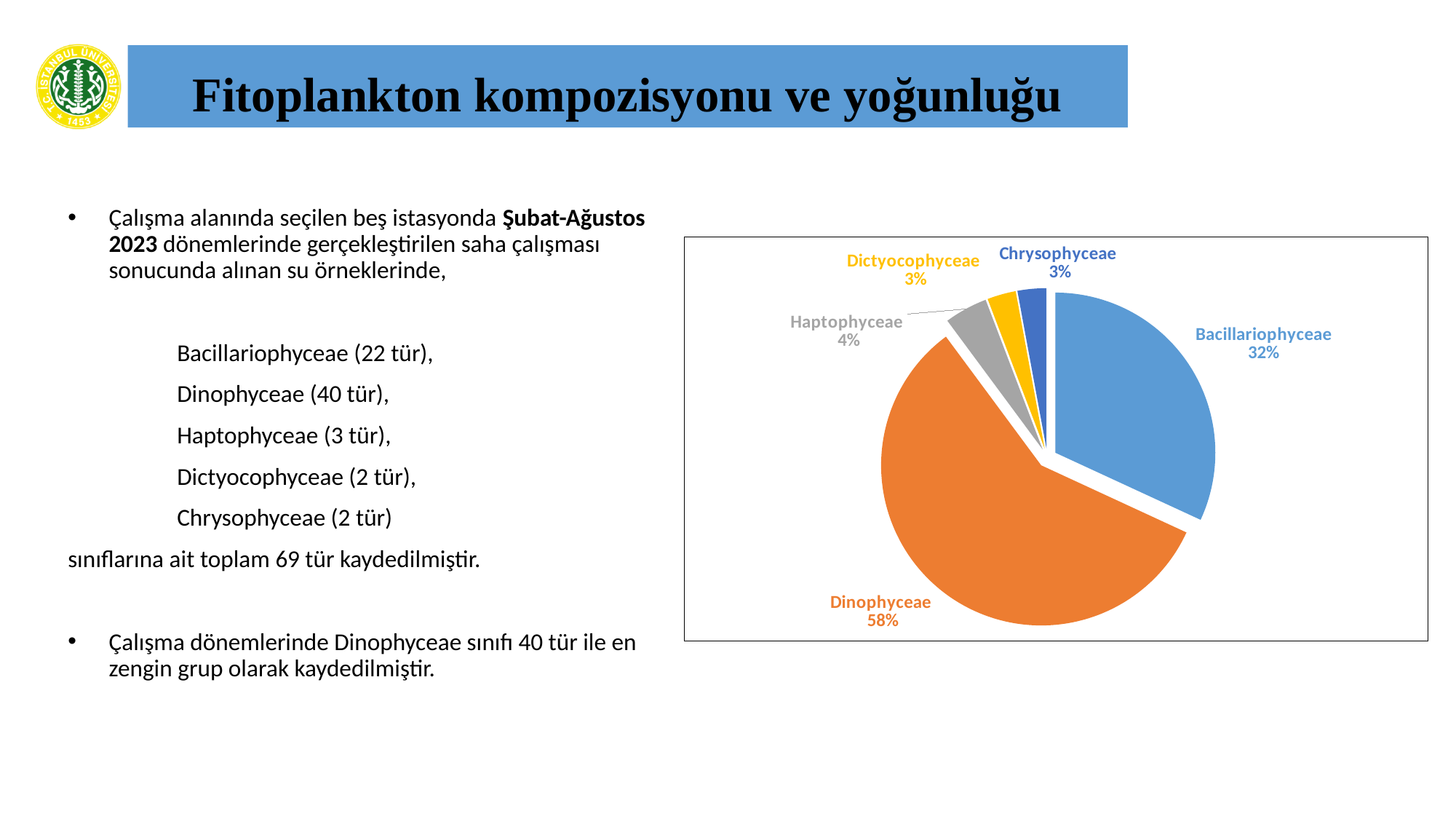
What share of the pie does Dictyocophyceae have? 3% How many slices does the pie chart have? 5 Which class has the largest slice of the pie? Dinophyceae What share of the pie does Bacillariophyceae have? 32% What is the combined share of the Bacillariophyceae and Dinophyceae slices? 90% What share of the pie does Haptophyceae have? 4% What kind of chart is shown on the slide? pie chart What colour is the Dinophyceae slice? orange Which slice is larger, Haptophyceae or Chrysophyceae? Haptophyceae What is the difference in percentage points between the Dinophyceae and Bacillariophyceae slices? 26 What colour is the Haptophyceae slice? grey